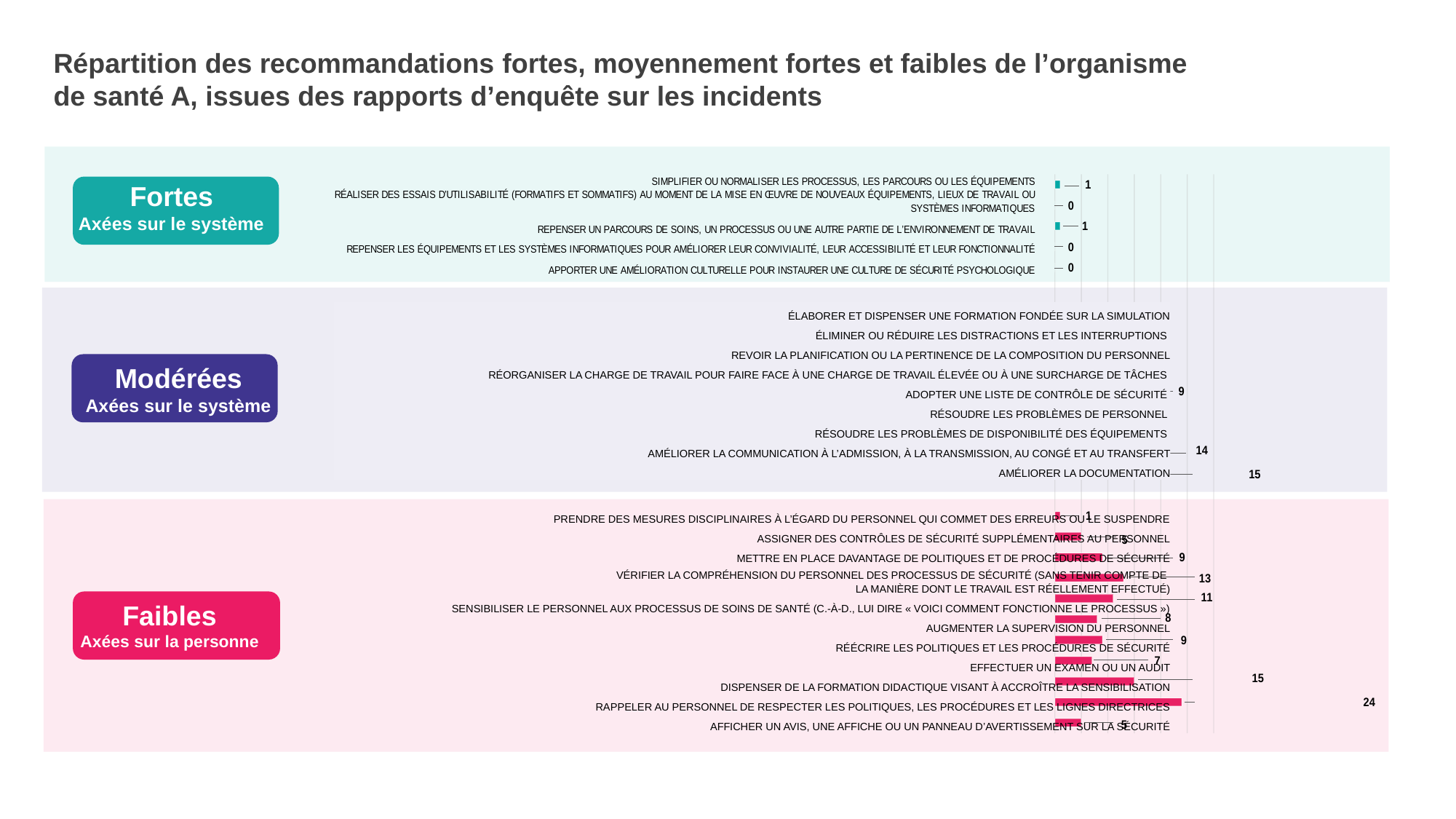
In the 'Modérées' chart, what is the value for 'AMÉLIORER LA DOCUMENTATION'? 15 In the 'Faibles' chart, which category has the highest value? RAPPELER AU PERSONNEL DE RESPECTER LES POLITIQUES, LES PROCÉDURES ET LES LIGNES DIRECTRICES In the 'Fortes' chart, what is the value for 'SIMPLIFIER OU NORMALISER LES PROCESSUS, LES PARCOURS OU LES ÉQUIPEMENTS'? 1 How many categories are shown in the 'Fortes' chart? 5 How many categories are shown in the 'Faibles' chart? 11 In the 'Modérées' chart, what is the value for 'AMÉLIORER LA COMMUNICATION À L'ADMISSION, À LA TRANSMISSION, AU CONGÉ ET AU TRANSFERT'? 14 In the 'Faibles' chart, which is larger: 'VÉRIFIER LA COMPRÉHENSION DU PERSONNEL DES PROCESSUS DE SÉCURITÉ' or 'EFFECTUER UN EXAMEN OU UN AUDIT'? VÉRIFIER LA COMPRÉHENSION DU PERSONNEL DES PROCESSUS DE SÉCURITÉ In the 'Faibles' chart, what is the value for 'RAPPELER AU PERSONNEL DE RESPECTER LES POLITIQUES, LES PROCÉDURES ET LES LIGNES DIRECTRICES'? 24 In the 'Faibles' chart, which category has the lowest value? PRENDRE DES MESURES DISCIPLINAIRES À L'ÉGARD DU PERSONNEL QUI COMMET DES ERREURS OU LE SUSPENDRE In the 'Faibles' chart, what is the difference between 'RAPPELER AU PERSONNEL DE RESPECTER LES POLITIQUES, LES PROCÉDURES ET LES LIGNES DIRECTRICES' and 'DISPENSER DE LA FORMATION DIDACTIQUE VISANT À ACCROÎTRE LA SENSIBILISATION'? 9 What type of chart is used in the 'Faibles' section? Bar chart In the 'Fortes' chart, what is the value for 'APPORTER UNE AMÉLIORATION CULTURELLE POUR INSTAURER UNE CULTURE DE SÉCURITÉ PSYCHOLOGIQUE'? 0